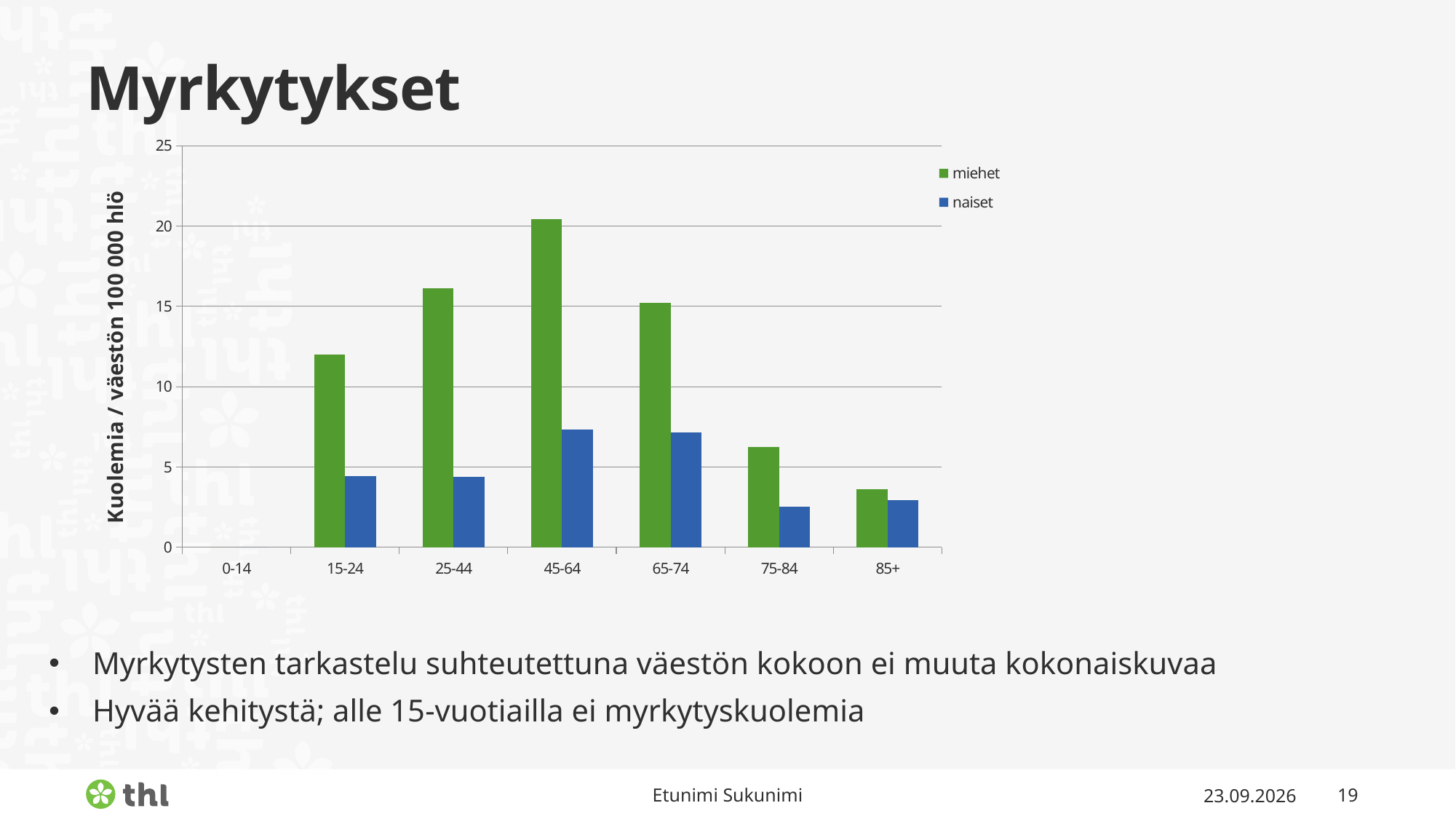
Is the value for miehet in the 15-24 age group greater or less than 10? greater Which age group has the highest value for miehet? 45-64 Is the value for naiset in the 45-64 age group greater or less than 5? greater What is the label of the vertical axis? Kuolemia / väestön 100 000 hlö Is the value for miehet in the 85+ age group greater or less than 5? less Which age group has no bars at all (zero for both miehet and naiset)? 0-14 How many age-group categories are shown on the x axis? 7 How many series does the chart legend list? 2 What kind of chart is shown on the slide? bar chart Do the miehet values rise or fall from the 45-64 age group to the 85+ age group? fall In the 25-44 age group, which series has the larger value, miehet or naiset? miehet